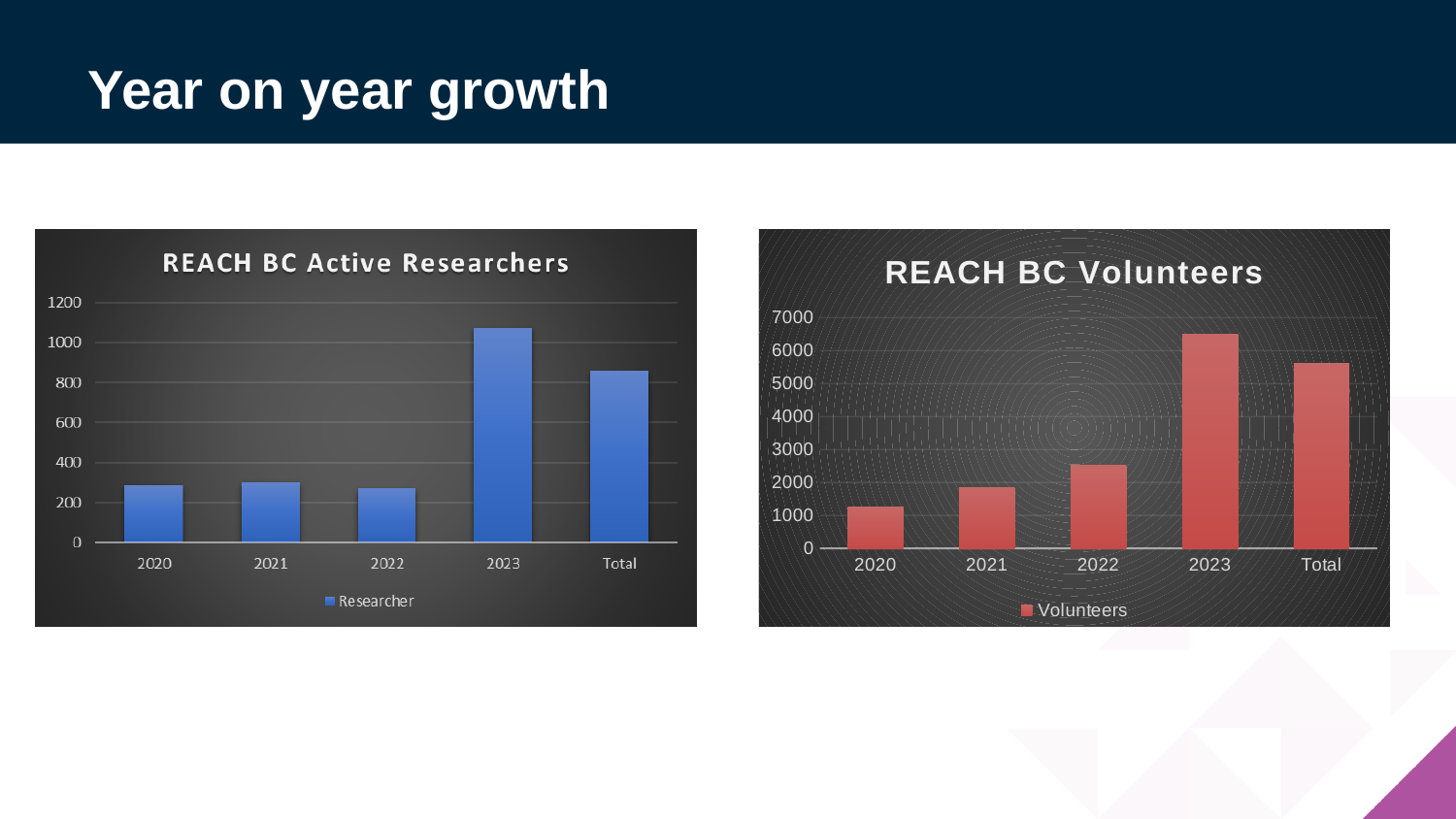
In the REACH BC Volunteers chart, is the value for Total greater or less than 5000? greater In the REACH BC Active Researchers chart, is the value for Total greater or less than 800? greater In the REACH BC Active Researchers chart, which is larger, the value for 2023 or the value for Total? 2023 In the REACH BC Volunteers chart, do the values rise or fall from 2020 to 2023? rise How many categories are shown on the x axis of the REACH BC Active Researchers chart? 5 In the REACH BC Volunteers chart, which category has the highest value? 2023 In the REACH BC Active Researchers chart, is the value for 2020 greater or less than 400? less What kind of chart is the REACH BC Volunteers chart? bar chart In the REACH BC Volunteers chart, which category has the lowest value? 2020 In the REACH BC Active Researchers chart, which category has the highest value? 2023